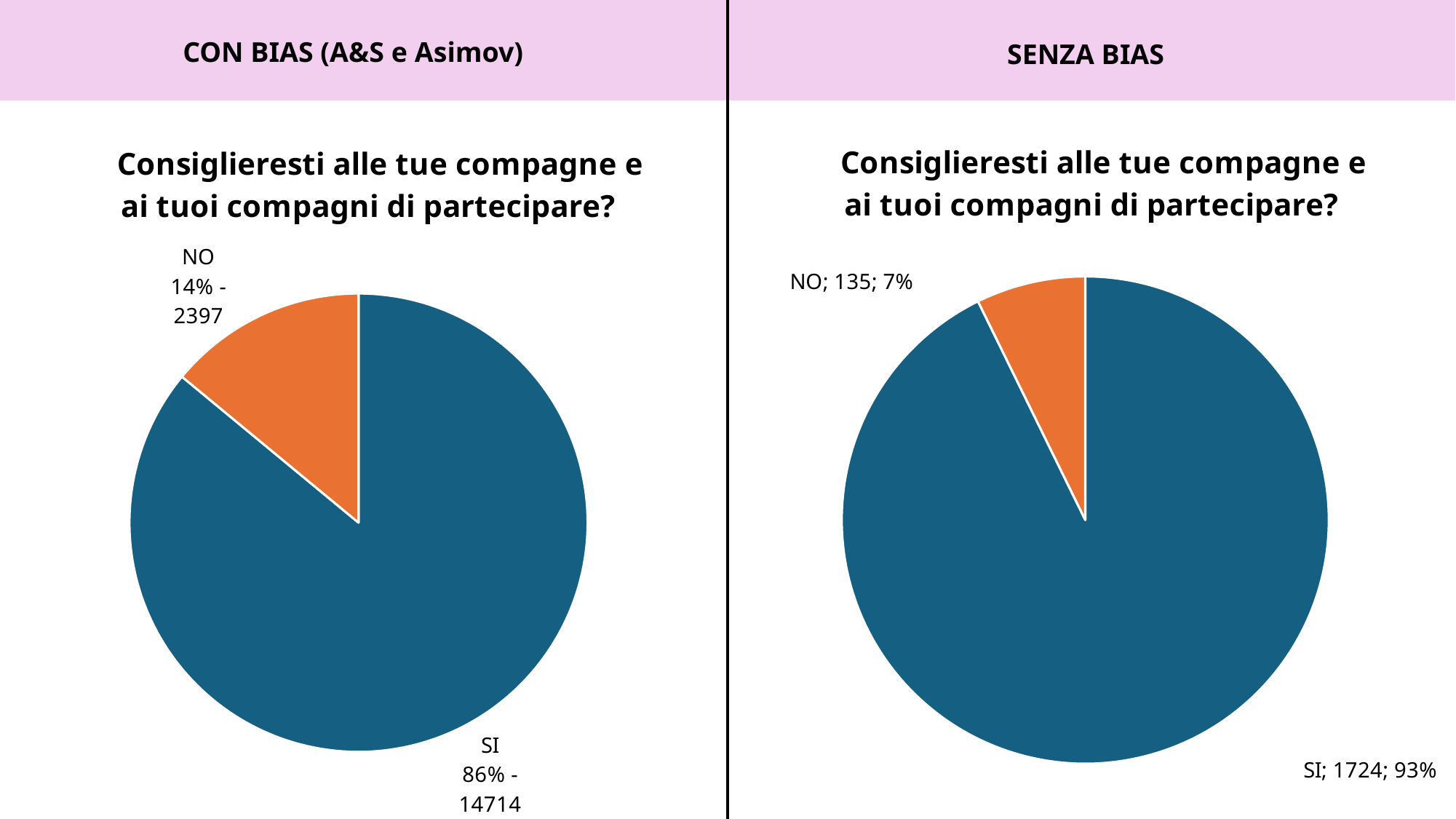
In the left pie chart (CON BIAS), how many responses are "SI"? 14714 What kind of chart is shown on the left side of the slide under "CON BIAS (A&S e Asimov)"? pie chart In the left pie chart (CON BIAS), what is the difference between the number of "SI" and "NO" responses? 12317 In the left pie chart (CON BIAS), which slice is the smallest? NO In the right pie chart (SENZA BIAS), what is the total number of responses across both slices? 1859 In the right pie chart (SENZA BIAS), how many responses are "SI"? 1724 In the left pie chart (CON BIAS), what share of responses is "NO"? 14% In the left pie chart (CON BIAS), how many responses are "NO"? 2397 How many slices does each pie chart on the slide have? 2 In the right pie chart (SENZA BIAS), what share of responses is "SI"? 93% In the right pie chart (SENZA BIAS), how many responses are "NO"? 135 In the right pie chart (SENZA BIAS), which slice is the largest? SI